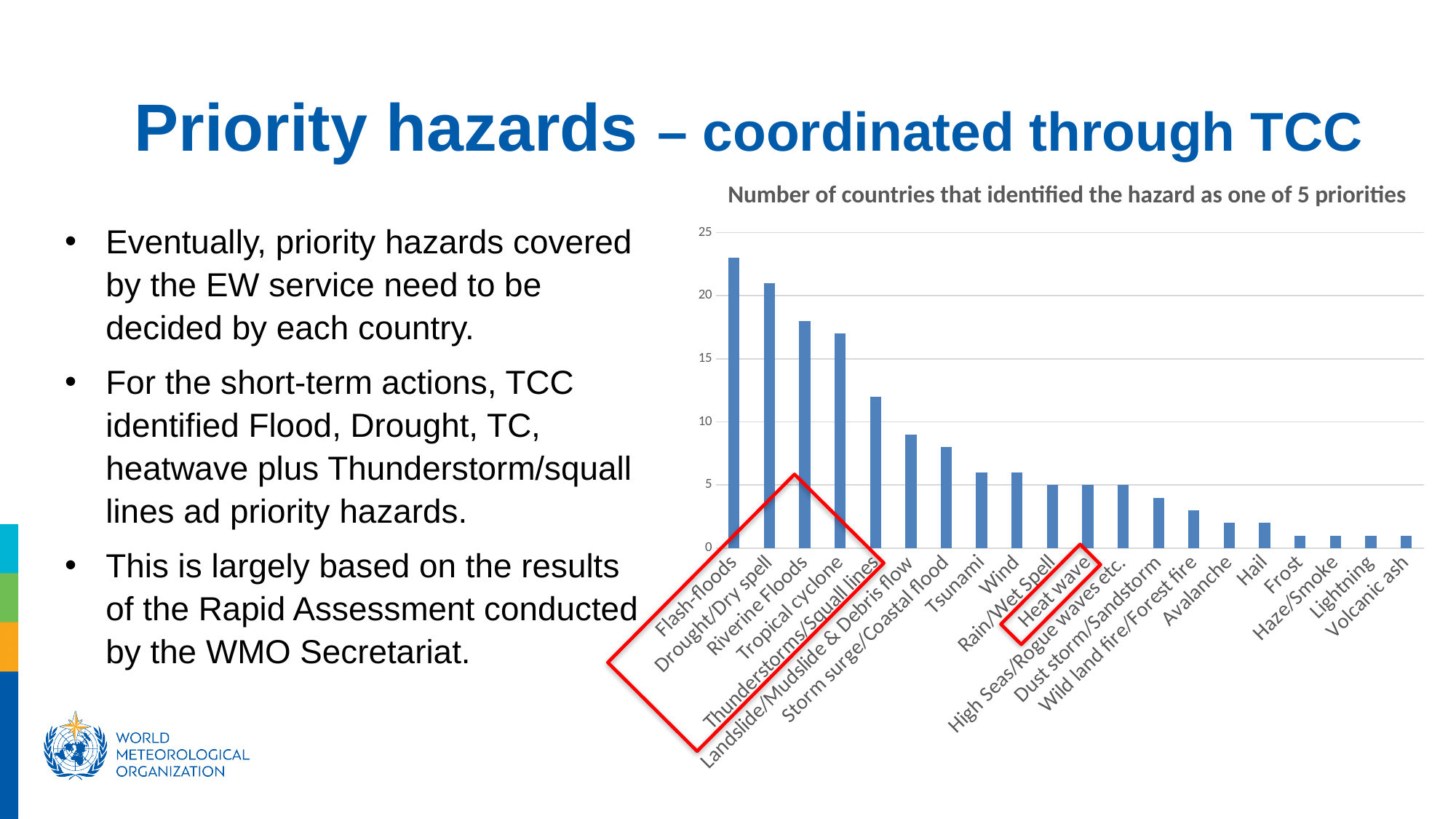
Is the value for Avalanche greater or less than 5? less What kind of chart is shown on the slide? bar chart Is the value for Flash-floods greater or less than 20? greater Which hazard has the highest number of countries identifying it as a priority? Flash-floods Do the values rise or fall moving from left to right along the x axis? fall How many hazard categories are shown on the x axis of the chart? 20 Which is larger, the value for Tsunami or the value for Dust storm/Sandstorm? Tsunami Is the value for Thunderstorms/Squall lines greater or less than 15? less What is the title of the chart? Number of countries that identified the hazard as one of 5 priorities Which is larger, the value for Drought/Dry spell or the value for Riverine Floods? Drought/Dry spell